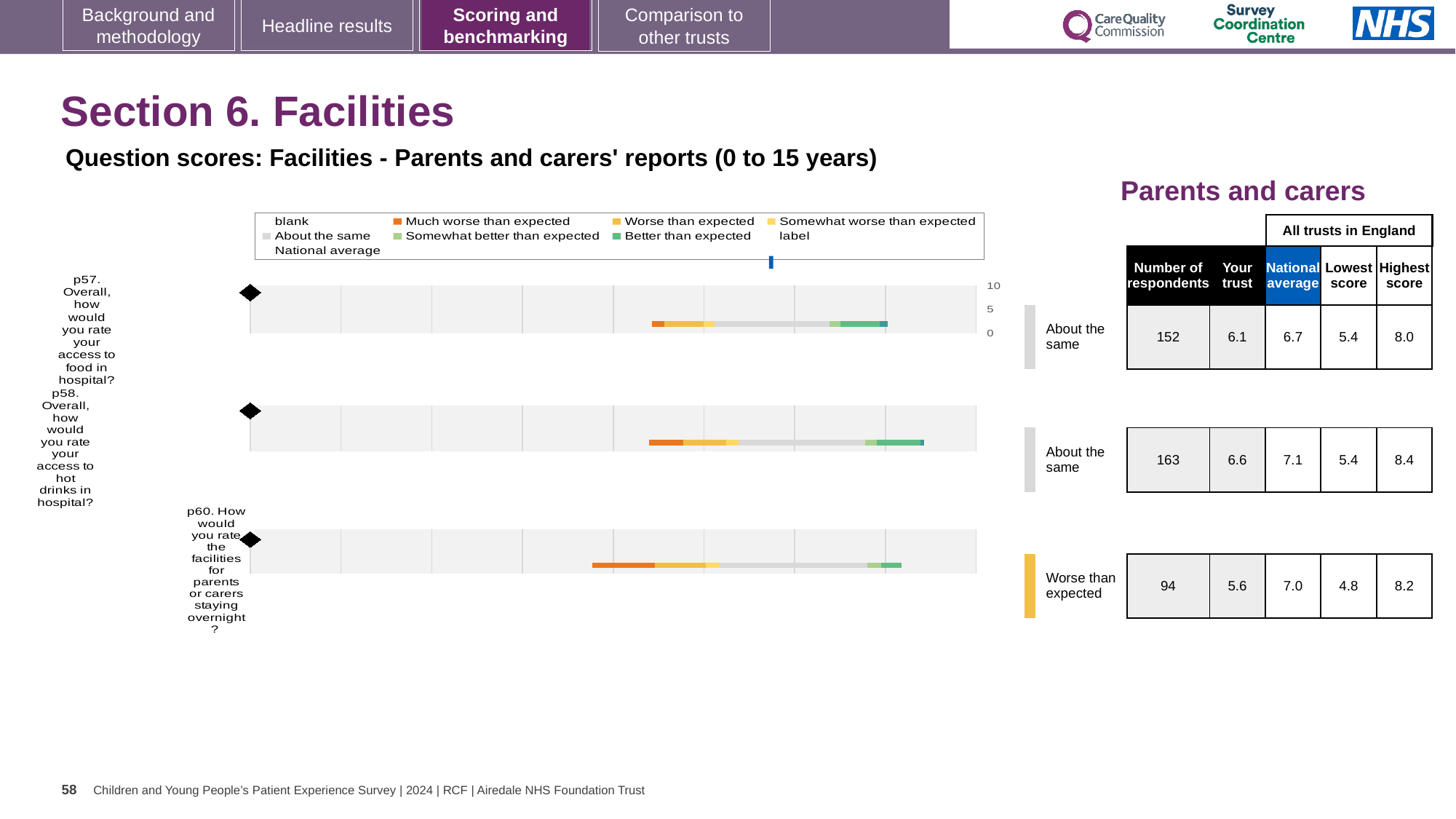
What is the difference between the national average and the 'Your trust' score for p60? 1.4 Which has the larger 'Your trust' score, p57 or p58? p58 Which question has the highest national average score? p58 (access to hot drinks in hospital) What kind of chart is used to show the question scores? Bar chart What is the national average score for p58 (access to hot drinks in hospital)? 7.1 What is the 'Your trust' score for p57 (access to food in hospital)? 6.1 What is the lowest score across all trusts in England for p60? 4.8 Which question has the lowest 'Your trust' score? p60 (facilities for parents or carers staying overnight) What benchmark category is shown for p60? Worse than expected How many questions are plotted on the slide? 3 How many respondents answered p60 (facilities for parents or carers staying overnight)? 94 What is the highest score across all trusts in England for p58? 8.4